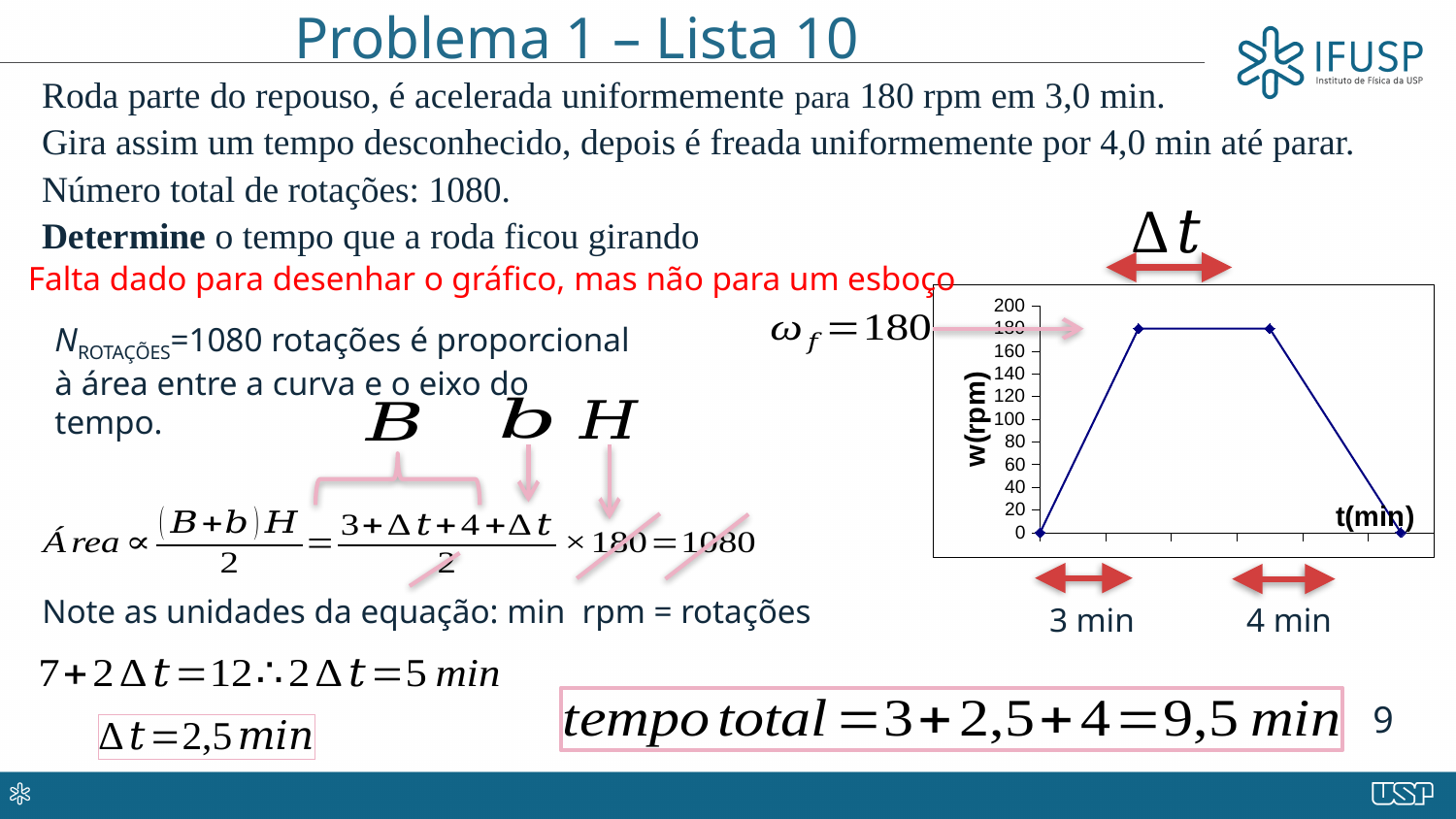
How many data point markers are plotted on the line in the chart? 4 According to the labels below the chart, how long does the rising segment of the line last? 3 min What is the label of the vertical axis of the chart? w(rpm) Does the line rise or fall between the first and second plotted points of the chart? rise What is the label of the horizontal axis of the chart? t(min) What kind of chart is shown on the slide? line chart What is the highest tick value shown on the vertical axis of the chart? 200 Does the line rise or fall between the third and fourth plotted points of the chart? fall What is the value of w(rpm) at the last plotted point of the chart? 0 What is the interval between consecutive tick labels on the vertical axis of the chart? 20 What is the value of w(rpm) at the first plotted point of the chart? 0 Is the value of the flat top section of the line in the chart greater or less than 100 rpm? greater